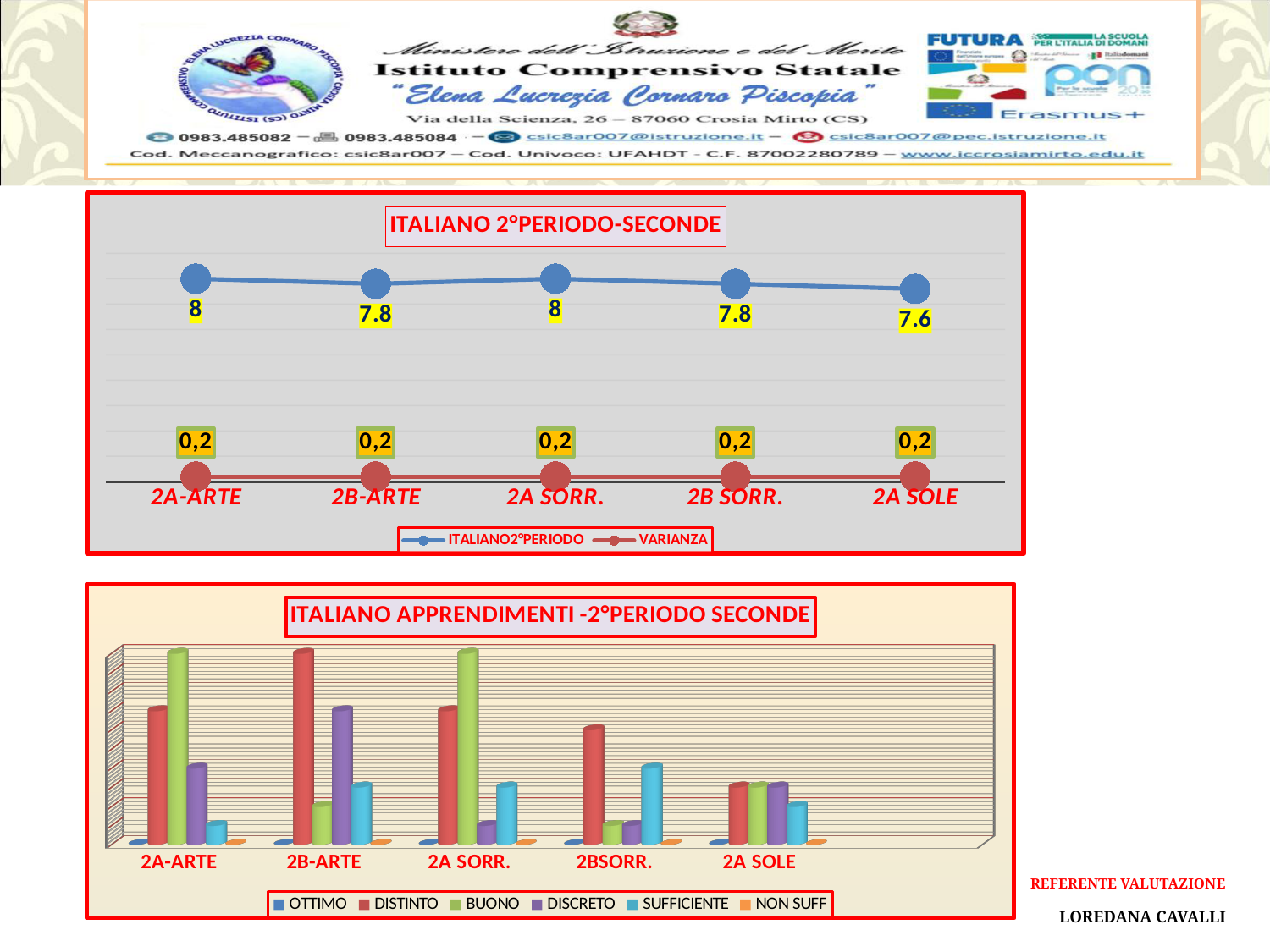
What kind of chart is the top chart titled 'ITALIANO 2°PERIODO-SECONDE'? Line chart In the chart titled 'ITALIANO 2°PERIODO-SECONDE', what is the VARIANZA value for 2B SORR.? 0,2 In the chart titled 'ITALIANO APPRENDIMENTI -2°PERIODO SECONDE', which series has the tallest bar for 2B-ARTE? DISTINTO In the chart titled 'ITALIANO 2°PERIODO-SECONDE', what is the difference between the ITALIANO2°PERIODO values for 2A-ARTE and 2A SOLE? 0.4 What kind of chart is the bottom chart titled 'ITALIANO APPRENDIMENTI -2°PERIODO SECONDE'? Bar chart In the chart titled 'ITALIANO 2°PERIODO-SECONDE', what is the ITALIANO2°PERIODO value for 2A-ARTE? 8 In the chart titled 'ITALIANO 2°PERIODO-SECONDE', which has the larger ITALIANO2°PERIODO value, 2B-ARTE or 2A SOLE? 2B-ARTE How many classes are shown on the x axis of the chart titled 'ITALIANO 2°PERIODO-SECONDE'? 5 How many series does the legend of the chart titled 'ITALIANO APPRENDIMENTI -2°PERIODO SECONDE' list? 6 In the chart titled 'ITALIANO 2°PERIODO-SECONDE', which class has the lowest ITALIANO2°PERIODO value? 2A SOLE How many series does the legend of the chart titled 'ITALIANO 2°PERIODO-SECONDE' list? 2 In the chart titled 'ITALIANO 2°PERIODO-SECONDE', what is the ITALIANO2°PERIODO value for 2A SOLE? 7.6